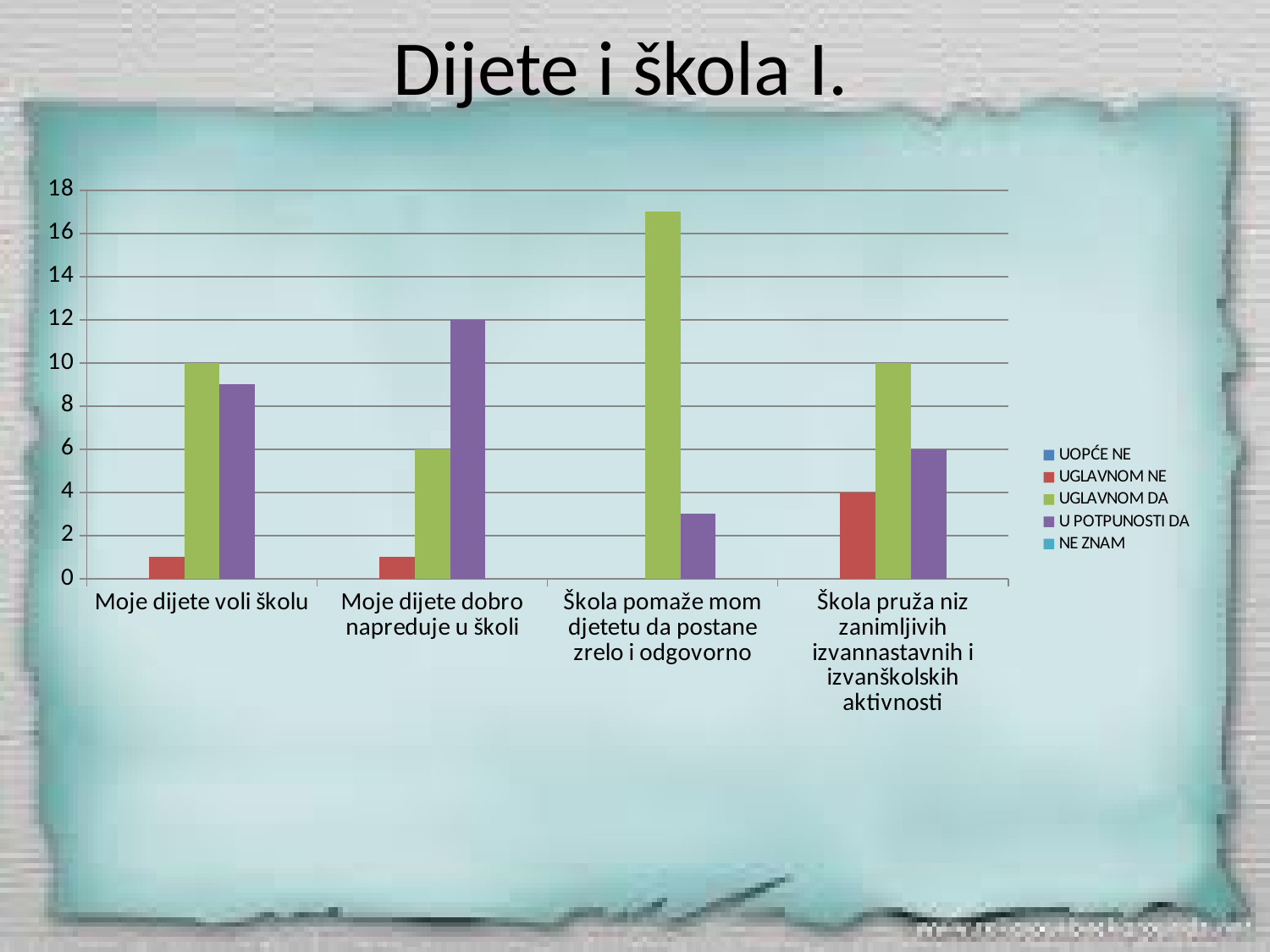
Is the value of UGLAVNOM DA for "Škola pomaže mom djetetu da postane zrelo i odgovorno" greater or less than 16? greater How many categories are shown on the x axis? 4 Which is larger: U POTPUNOSTI DA for "Moje dijete dobro napreduje u školi" or U POTPUNOSTI DA for "Moje dijete voli školu"? Moje dijete dobro napreduje u školi What is the value of U POTPUNOSTI DA for "Škola pruža niz zanimljivih izvannastavnih i izvanškolskih aktivnosti"? 6 What is the difference between U POTPUNOSTI DA and UGLAVNOM DA for "Moje dijete dobro napreduje u školi"? 6 What kind of chart is shown on the slide? bar chart How many series does the legend list? 5 What is the value of U POTPUNOSTI DA for "Moje dijete dobro napreduje u školi"? 12 For which category is the UGLAVNOM DA bar the highest? Škola pomaže mom djetetu da postane zrelo i odgovorno What is the value of UGLAVNOM DA for "Moje dijete voli školu"? 10 Is the value of U POTPUNOSTI DA for "Škola pomaže mom djetetu da postane zrelo i odgovorno" greater or less than 4? less What is the value of UGLAVNOM NE for "Škola pruža niz zanimljivih izvannastavnih i izvanškolskih aktivnosti"? 4